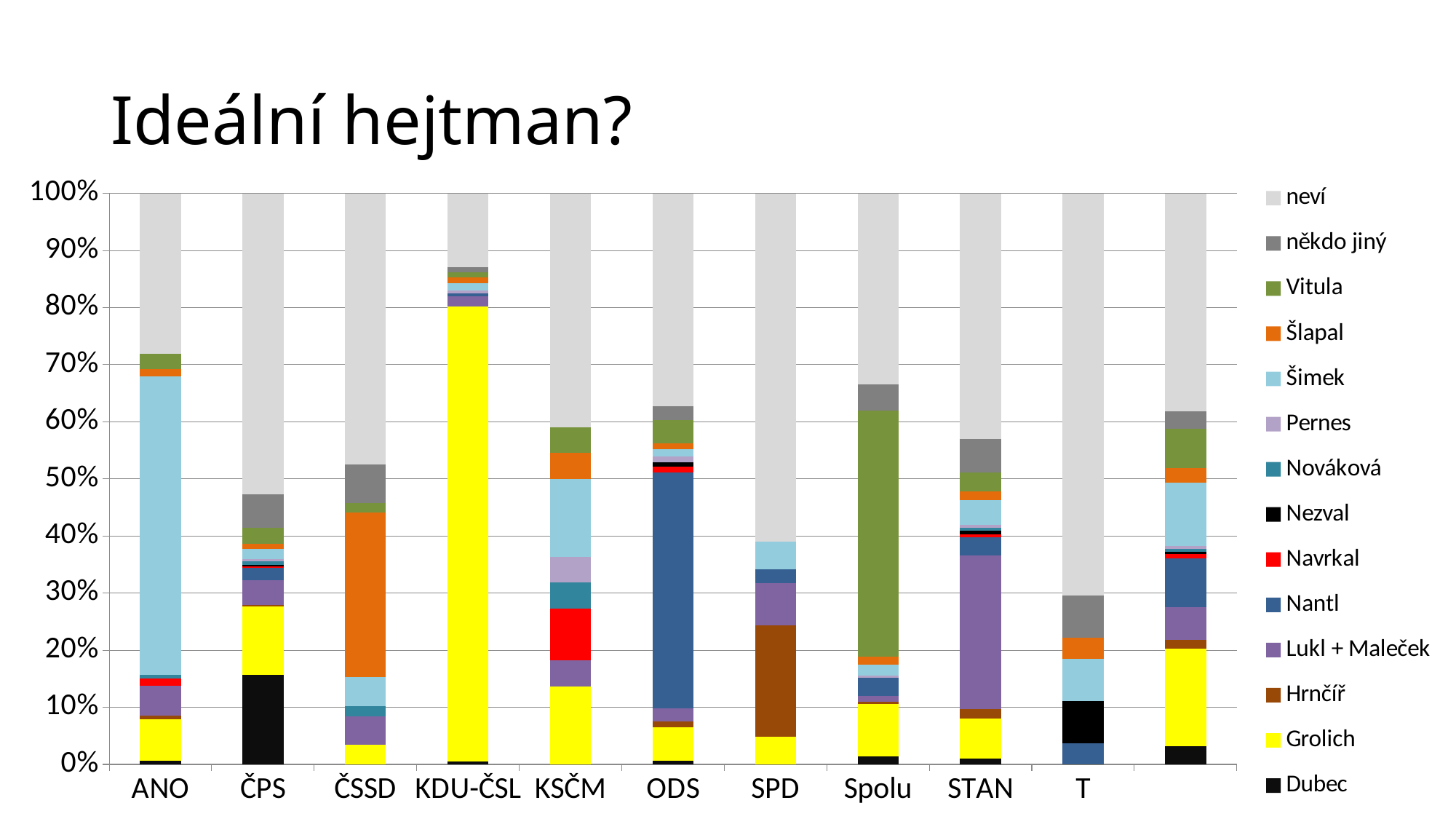
Is the Grolich segment for KDU-ČSL greater or less than 70%? greater Which category has the smallest neví segment? KDU-ČSL Which is larger: the Nantl segment for ODS or the Nantl segment for SPD? ODS What kind of chart is shown on the slide? stacked bar chart Is the Vitula segment for Spolu greater or less than 30%? greater Which category has the largest Grolich segment? KDU-ČSL How many stacked bars are plotted in the chart? 11 What is the title of the chart? Ideální hejtman? Is the Šimek segment for ANO greater or less than 40%? greater How many series does the legend list? 14 Which category has the largest neví segment? T